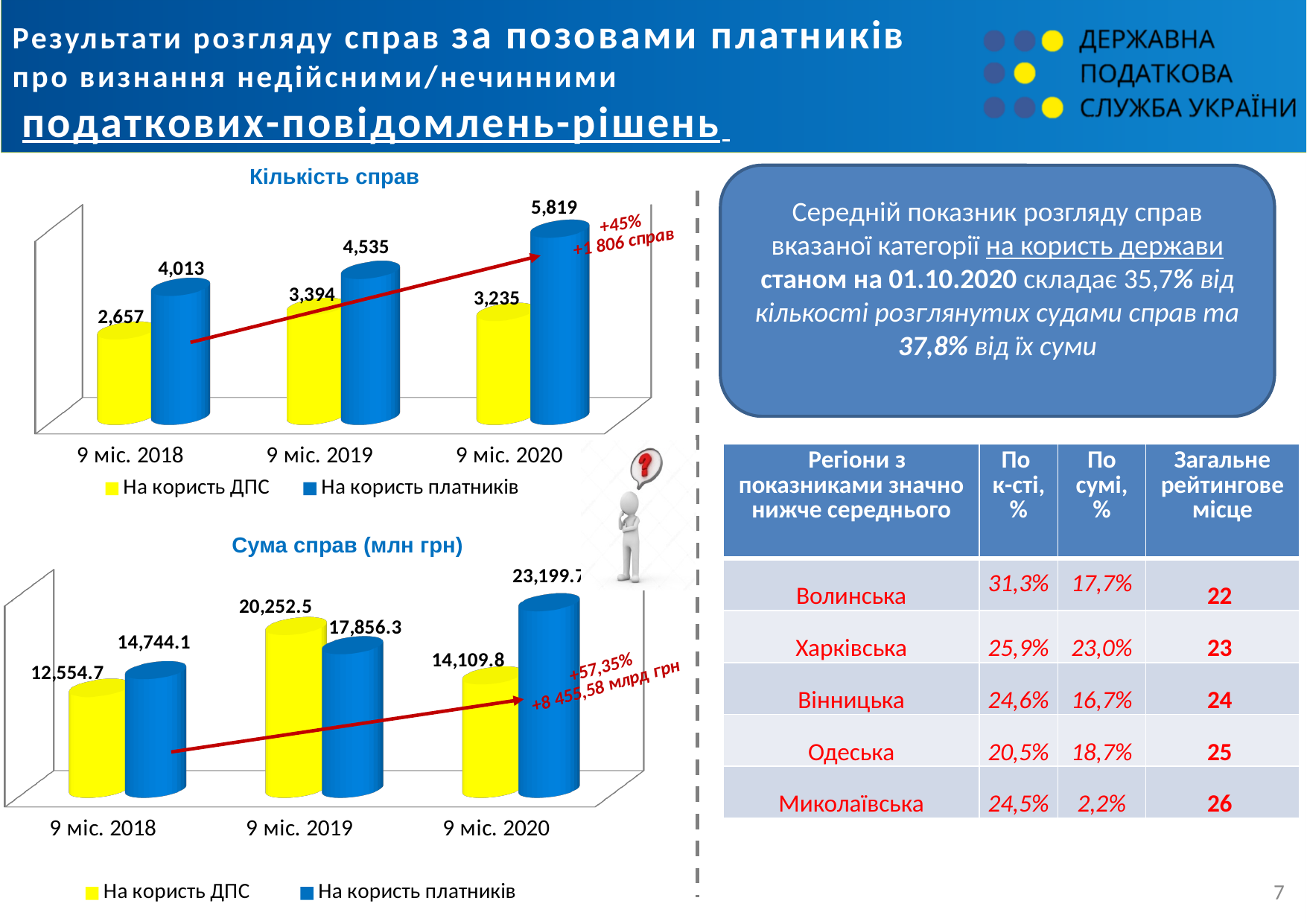
How many periods are shown on the x axis of the 'Сума справ (млн грн)' chart? 3 In the 'Сума справ (млн грн)' chart, what is the value for 'На користь платників' in 9 міс. 2018? 14,744.1 In the 'Сума справ (млн грн)' chart, what is the value for 'На користь ДПС' in 9 міс. 2019? 20,252.5 In the 'Сума справ (млн грн)' chart, which is larger in 9 міс. 2019: 'На користь ДПС' or 'На користь платників'? На користь ДПС In the 'Кількість справ' chart, does the 'На користь платників' series rise or fall from 9 міс. 2018 to 9 міс. 2020? rise In the 'Кількість справ' chart, which period has the highest value for 'На користь ДПС'? 9 міс. 2019 In the 'Сума справ (млн грн)' chart, which period has the lowest value for 'На користь ДПС'? 9 міс. 2018 In the 'Кількість справ' chart, what is the difference between 'На користь платників' and 'На користь ДПС' in 9 міс. 2020? 2,584 In the 'Кількість справ' chart, what is the value for 'На користь ДПС' in 9 міс. 2018? 2,657 In the 'Кількість справ' chart, what is the value for 'На користь платників' in 9 міс. 2020? 5,819 How many series does the legend of the 'Кількість справ' chart list? 2 What type of chart is the 'Сума справ (млн грн)' chart? bar chart